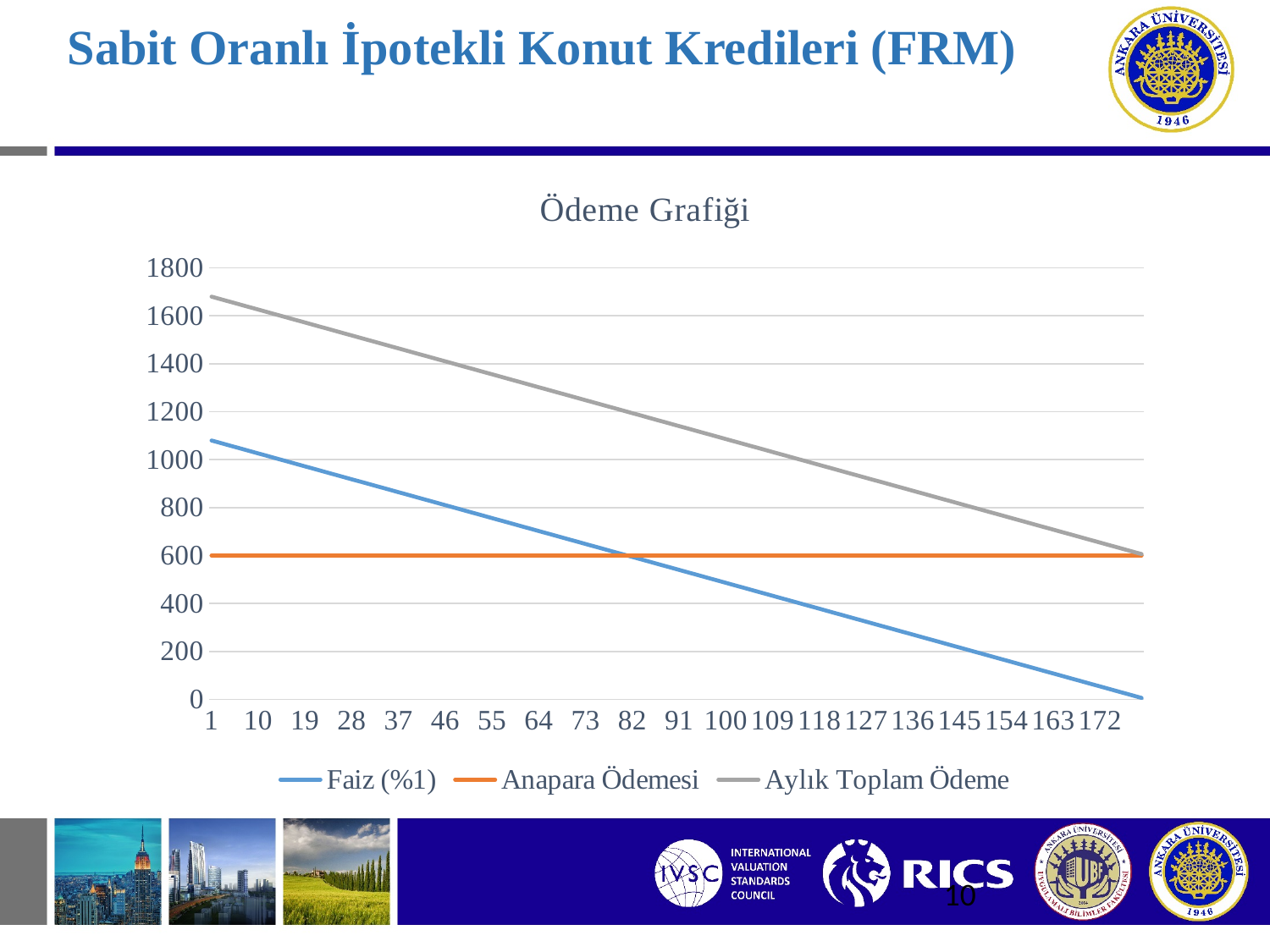
Is the value for Faiz (%1) at x = 1 greater or less than 1000? greater Does the Anapara Ödemesi line rise, fall, or stay constant along the x axis? stay constant Is the value for Aylık Toplam Ödeme at x = 55 greater or less than 1200? greater Does the Faiz (%1) line rise or fall along the x axis? fall Which series has the highest value at x = 1? Aylık Toplam Ödeme Which series is shown in orange in the legend? Anapara Ödemesi How many series does the legend list? 3 What is the title of the chart? Ödeme Grafiği What kind of chart is shown on the slide? line chart What is the value of Anapara Ödemesi across the chart? 600